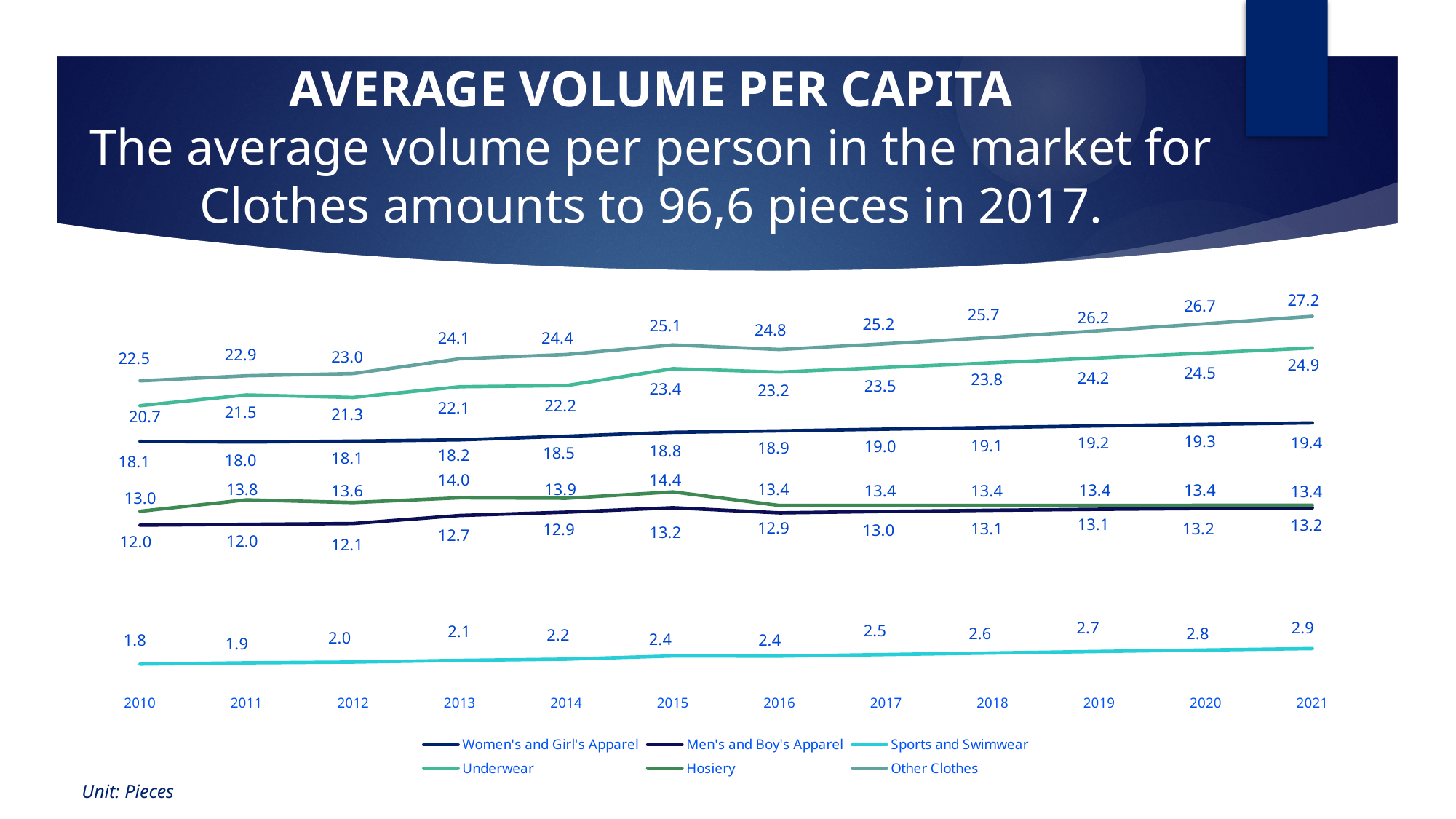
What kind of chart is shown on the slide? Line chart Which is larger in 2015: the value for Underwear or the value for Hosiery? Underwear What is the difference between the Other Clothes value in 2021 and in 2010? 4.7 Does the Sports and Swimwear series rise or fall from 2010 to 2021? Rise What is the value for Sports and Swimwear in 2017? 2.5 What is the value for Hosiery in 2015? 14.4 How many series does the legend list? 6 How many years are shown on the x axis? 12 Which series has the highest value in 2021? Other Clothes What is the value for Other Clothes in 2021? 27.2 Which series has the lowest value in 2010? Sports and Swimwear What is the value for Underwear in 2010? 20.7